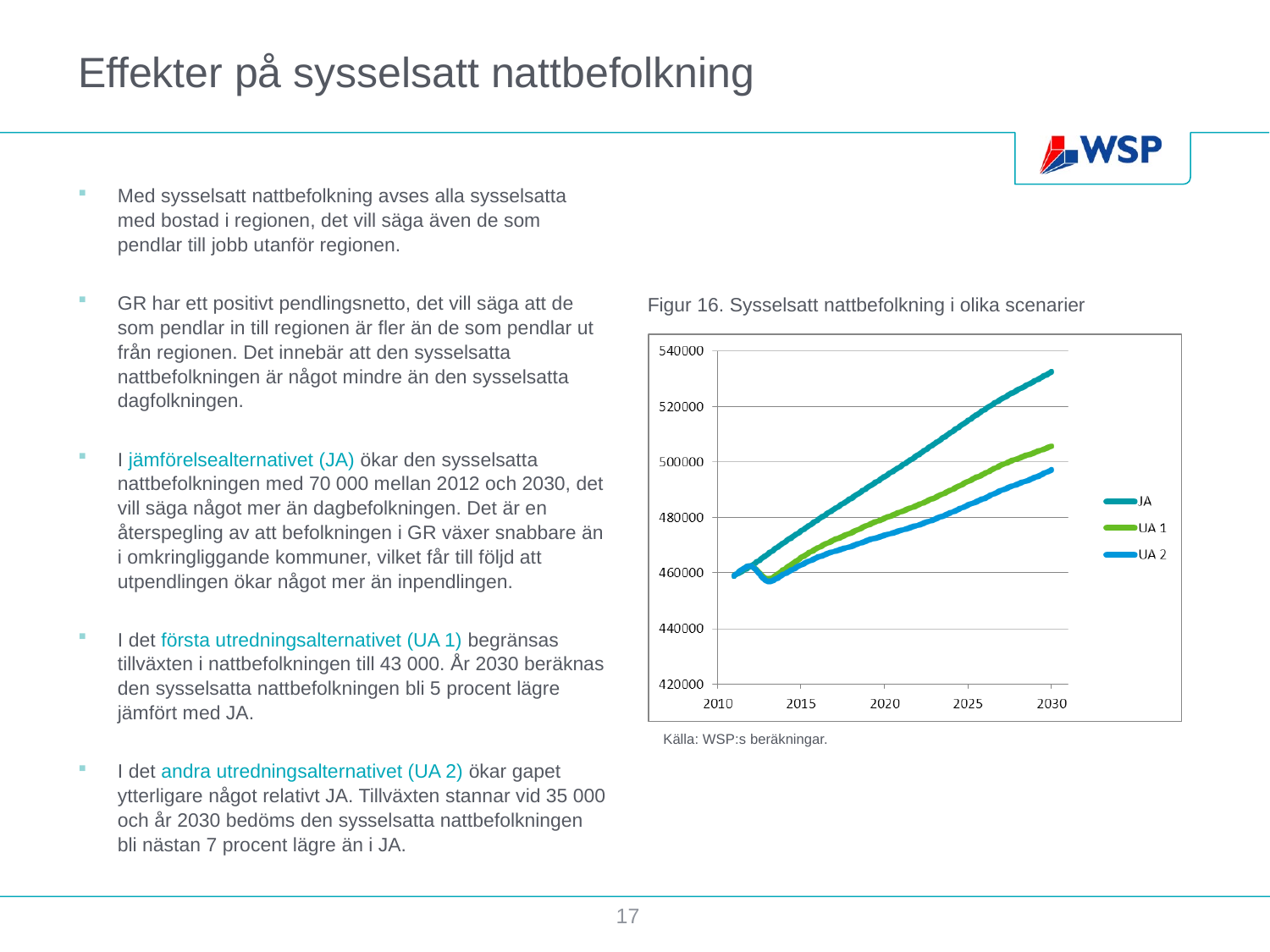
Which series has the lowest value in 2030? UA 2 Is the value for UA 2 in 2015 greater or less than 480000? less Is the value for JA in 2030 greater or less than 520000? greater Which series has the highest value in 2030? JA Is the value for UA 2 in 2030 greater or less than 480000? greater What are the three series listed in the chart legend? JA, UA 1, UA 2 What is the title of the chart? Figur 16. Sysselsatt nattbefolkning i olika scenarier How many series does the legend of the chart list? 3 Which is larger in 2025, the value for JA or the value for UA 2? JA What kind of chart is shown in Figur 16? line chart Do the values for JA rise or fall from 2015 to 2030? rise